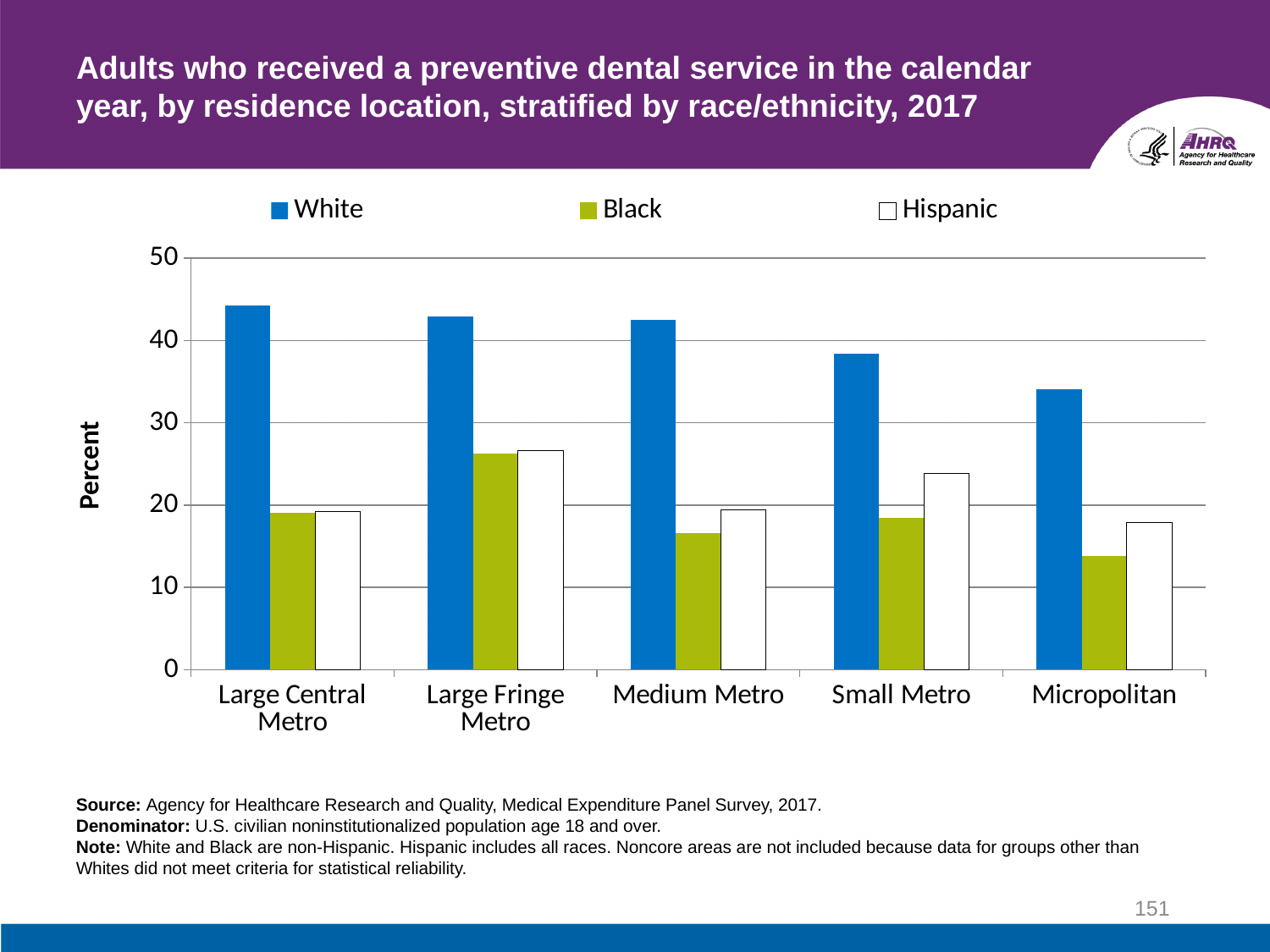
How many residence location categories are shown on the x axis? 5 Is the value for White in Micropolitan greater or less than 40? less What kind of chart is shown on the slide? bar chart Is the value for Hispanic in Small Metro greater or less than 20? greater How many series does the legend list? 3 In Small Metro, which is larger, the value for Black or the value for Hispanic? Hispanic Is the value for Black in Large Fringe Metro greater or less than 20? greater Do the values for White rise or fall moving from Large Central Metro to Micropolitan? fall Which residence location has the lowest value for White? Micropolitan Which residence location has the highest value for Black? Large Fringe Metro